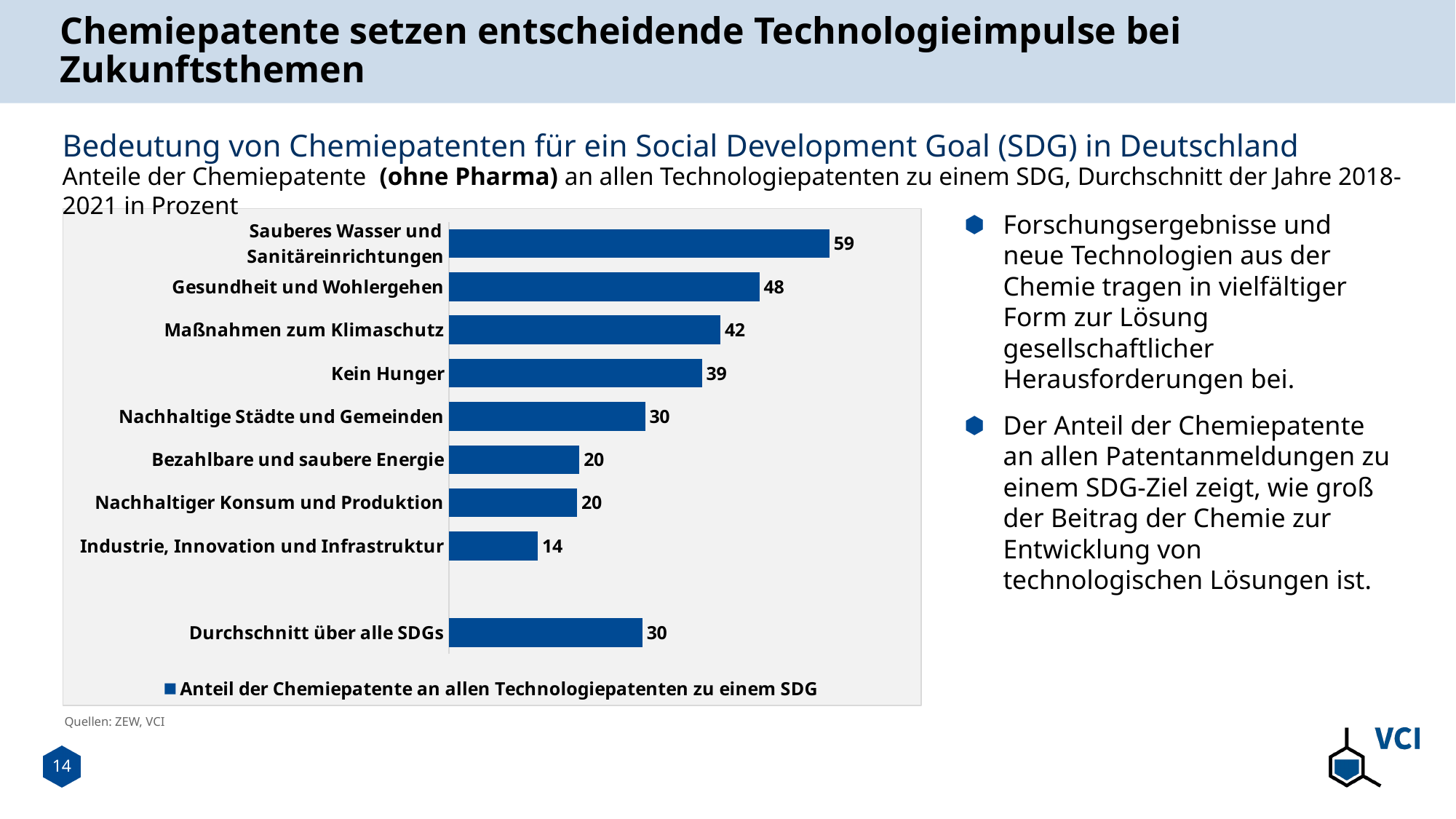
What is the value for Durchschnitt über alle SDGs? 30 What is the difference between the values for Gesundheit und Wohlergehen and Kein Hunger? 9 What kind of chart is shown on the slide? Bar chart What is the value for Sauberes Wasser und Sanitäreinrichtungen? 59 What is the value for Maßnahmen zum Klimaschutz? 42 Which category has the lowest value? Industrie, Innovation und Infrastruktur How many series does the legend list? 1 What is the legend entry of the chart? Anteil der Chemiepatente an allen Technologiepatenten zu einem SDG Which is larger, the value for Nachhaltige Städte und Gemeinden or the value for Bezahlbare und saubere Energie? Nachhaltige Städte und Gemeinden What sources are cited below the chart? ZEW, VCI Which category has the highest value? Sauberes Wasser und Sanitäreinrichtungen How many bars are shown in the chart? 9